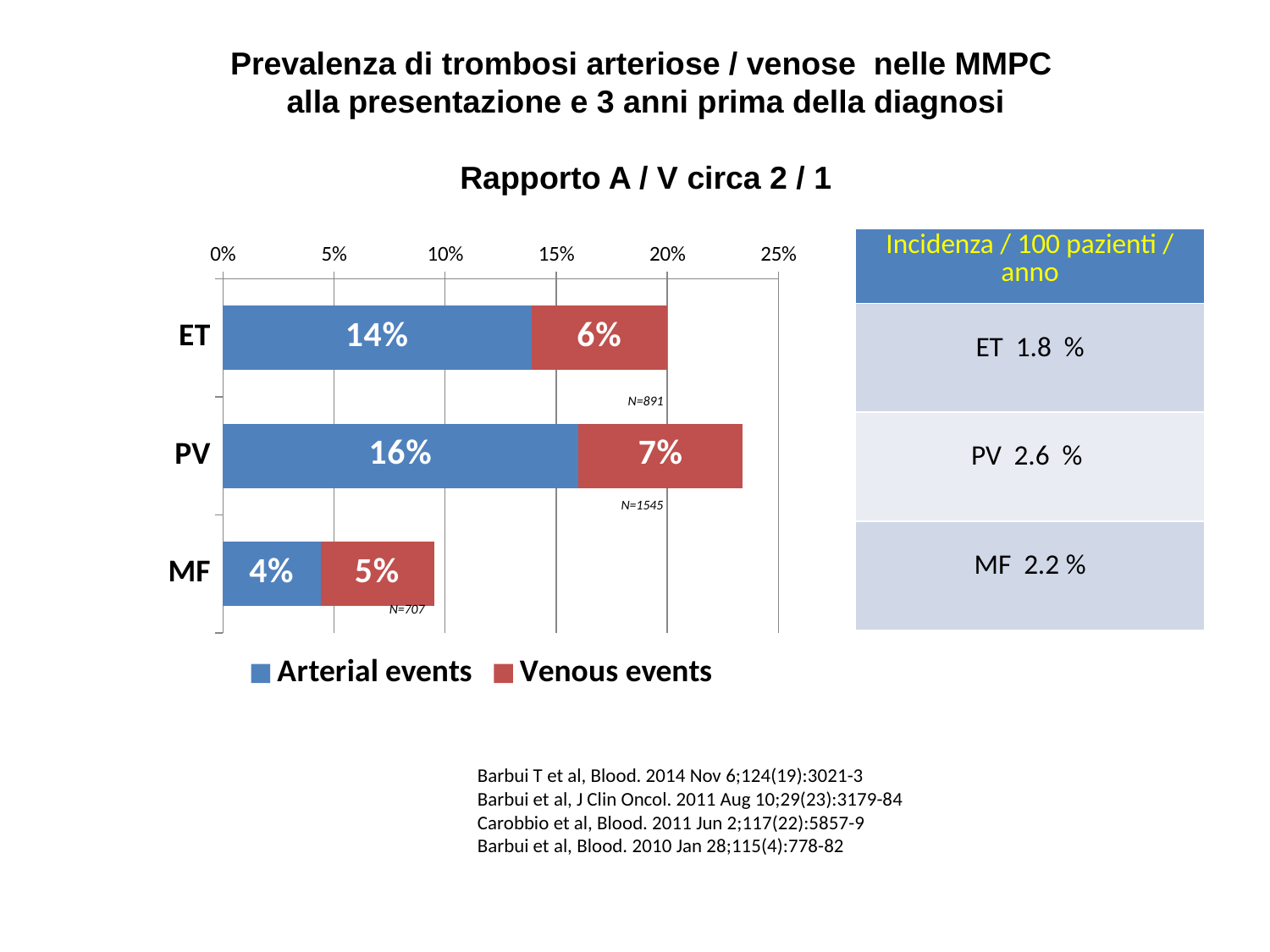
Which category has the lowest value for Venous events? MF What is the value for Arterial events for MF? 4% What is the difference between the Arterial events values for PV and ET? 2% Which is larger for MF: Arterial events or Venous events? Venous events What is the total of the stacked bar for ET? 20% Which category has the highest value for Arterial events? PV How many series does the legend list? 2 What is the total of the stacked bar for PV? 23% What is the value for Arterial events for PV? 16% How many categories are shown on the chart? 3 What kind of chart is shown? Stacked bar chart What is the value for Venous events for ET? 6%